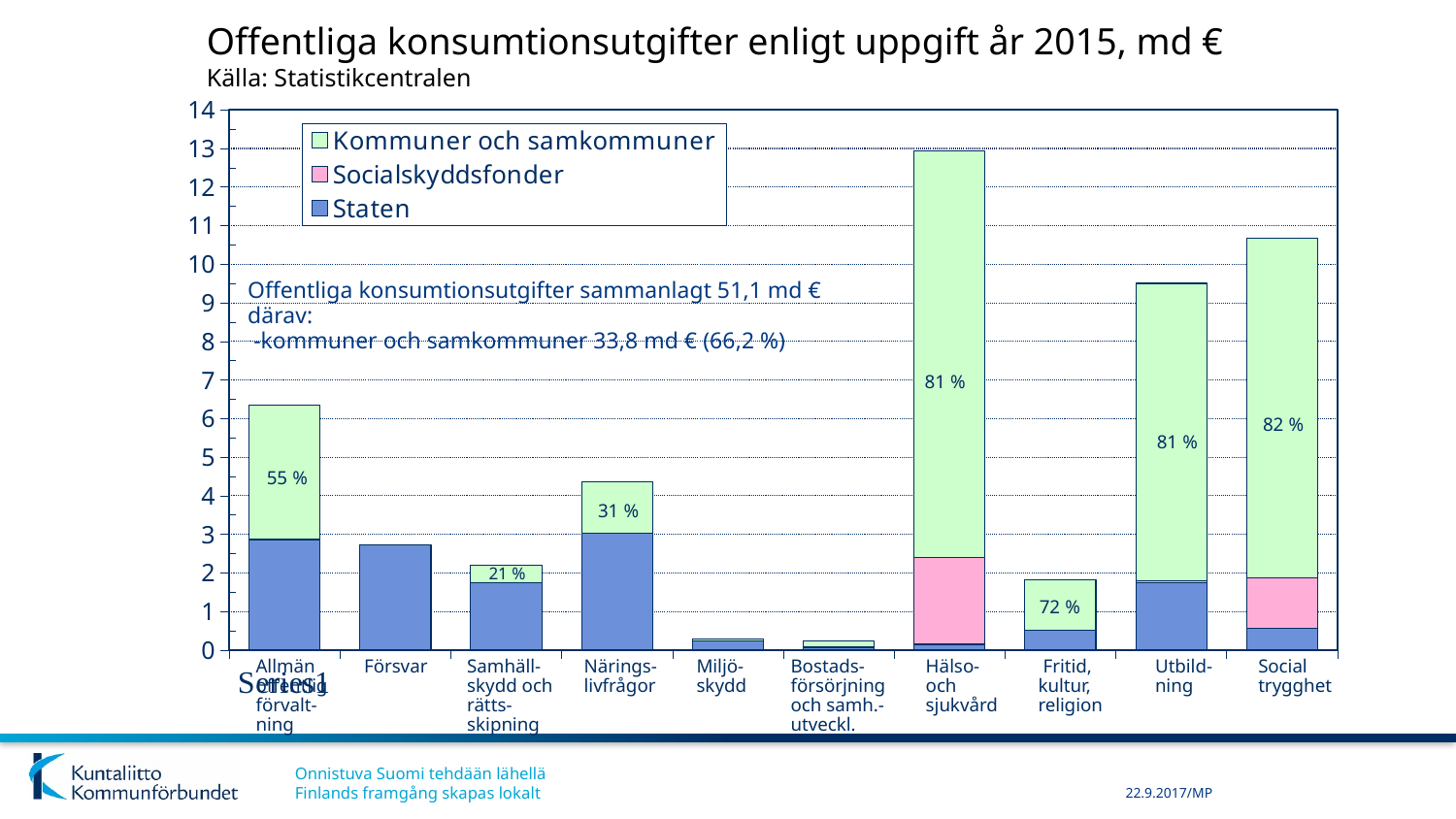
Is the total value for Försvar greater or less than 3? less How many categories are shown on the x axis? 10 Which has the larger total bar, Utbildning or Social trygghet? Social trygghet Which category has the highest total bar? Hälso- och sjukvård What kind of chart is shown on the slide? Stacked bar chart What percentage label is shown on the Samhällskydd och rättsskipning bar? 21 % Which series is shown in green in the legend? Kommuner och samkommuner How many series does the legend list? 3 What percentage label is shown on the Hälso- och sjukvård bar? 81 % What percentage label is shown on the Fritid, kultur, religion bar? 72 % Is the total value for Hälso- och sjukvård greater or less than 12? greater What percentage label is shown on the Social trygghet bar? 82 %